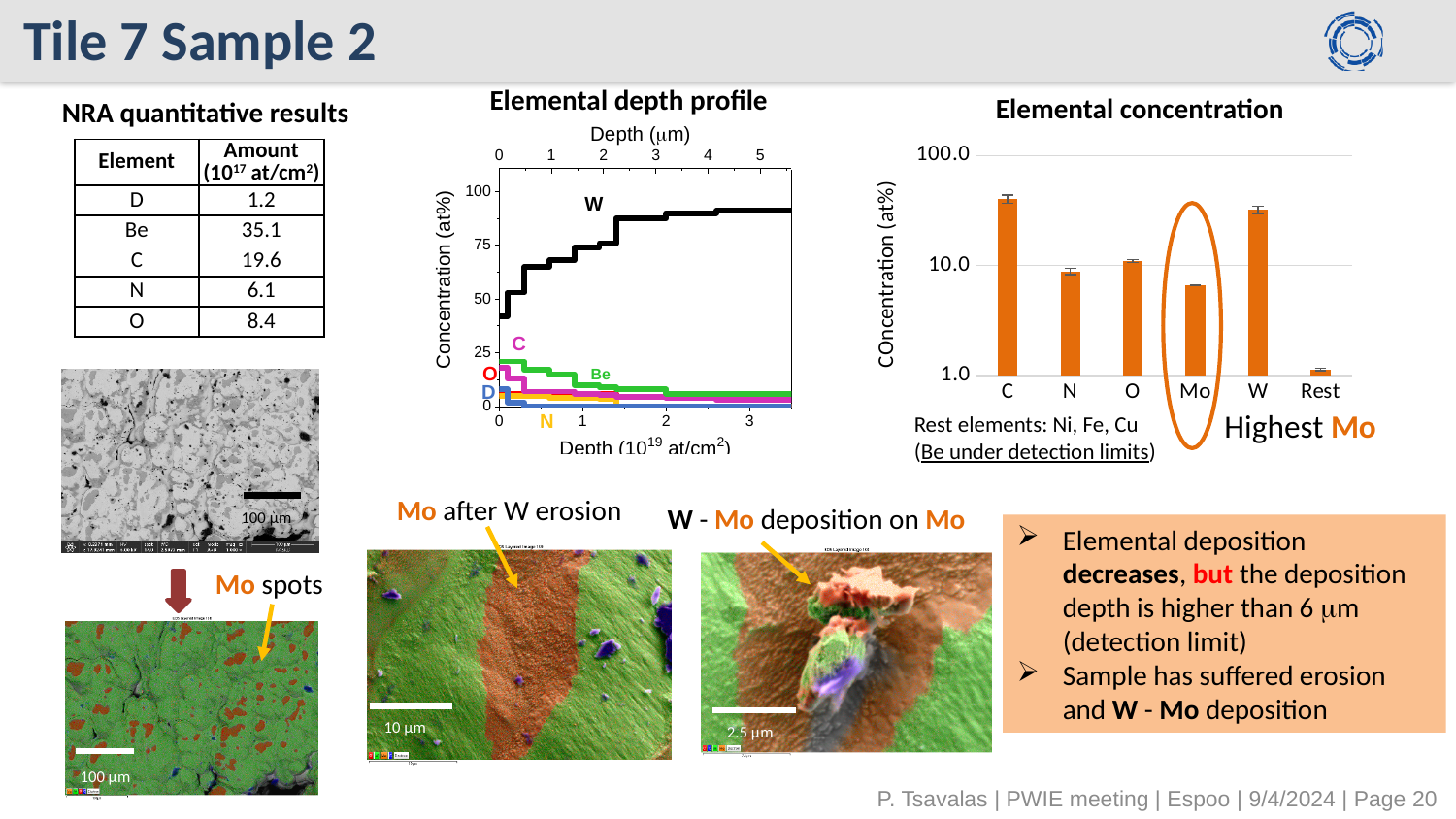
In the 'Elemental concentration' chart, which is larger, the value for N or the value for C? C How many categories are shown on the x axis of the 'Elemental concentration' chart? 6 In the 'Elemental concentration' chart, which element has the highest concentration? C In the 'Elemental concentration' chart, which category has the lowest concentration? Rest In the 'Elemental concentration' chart, is the value for Mo greater or less than 10.0? less In the 'Elemental concentration' chart, is the value for W greater or less than 10.0? greater In the 'Elemental depth profile' chart, does the W concentration rise or fall as depth increases? rise What is the y-axis title of the 'Elemental depth profile' chart? Concentration (at%) In the 'Elemental concentration' chart, which is larger, the value for W or the value for Mo? W In the 'Elemental depth profile' chart, does the C concentration rise or fall as depth increases? fall In the 'Elemental concentration' chart, is the value for N greater or less than 10.0? less What kind of chart is the 'Elemental concentration' chart? bar chart